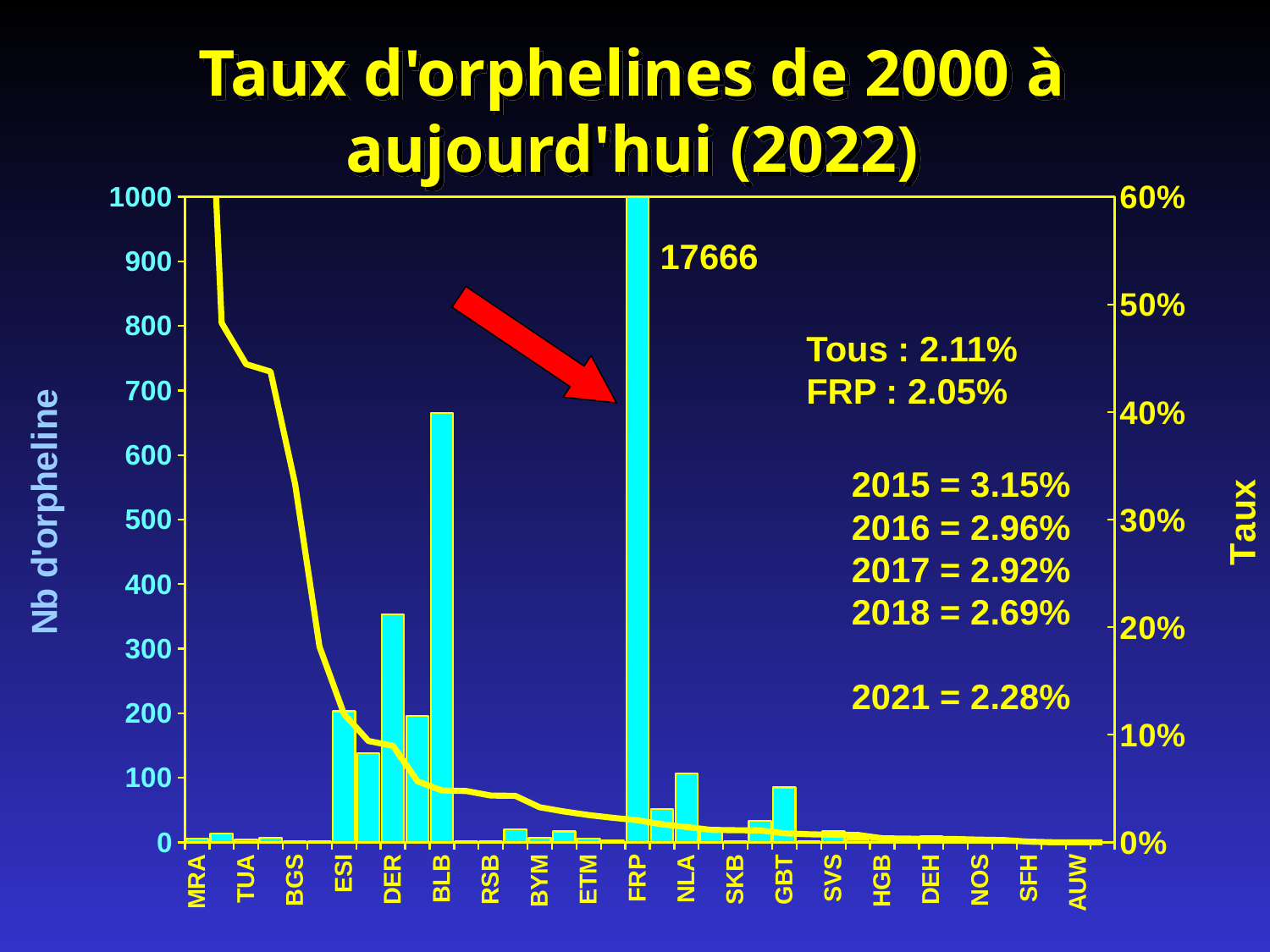
Which category has the highest bar? FRP Is the bar value for DER greater or less than 300? greater Is the bar value for NLA greater or less than 200? less What is the title of the chart? Taux d'orphelines de 2000 à aujourd'hui (2022) Does the yellow Taux line rise or fall from left to right along the x axis? fall What kind of chart is shown on the slide? bar chart with a line Which bar is taller, DER or ESI? DER Is the bar value for ESI greater or less than 300? less What is the label of the right-hand vertical axis? Taux What is the number of orphelines (Nb d'orpheline) for FRP, as printed on the chart? 17666 Which bar is taller, BLB or DER? BLB